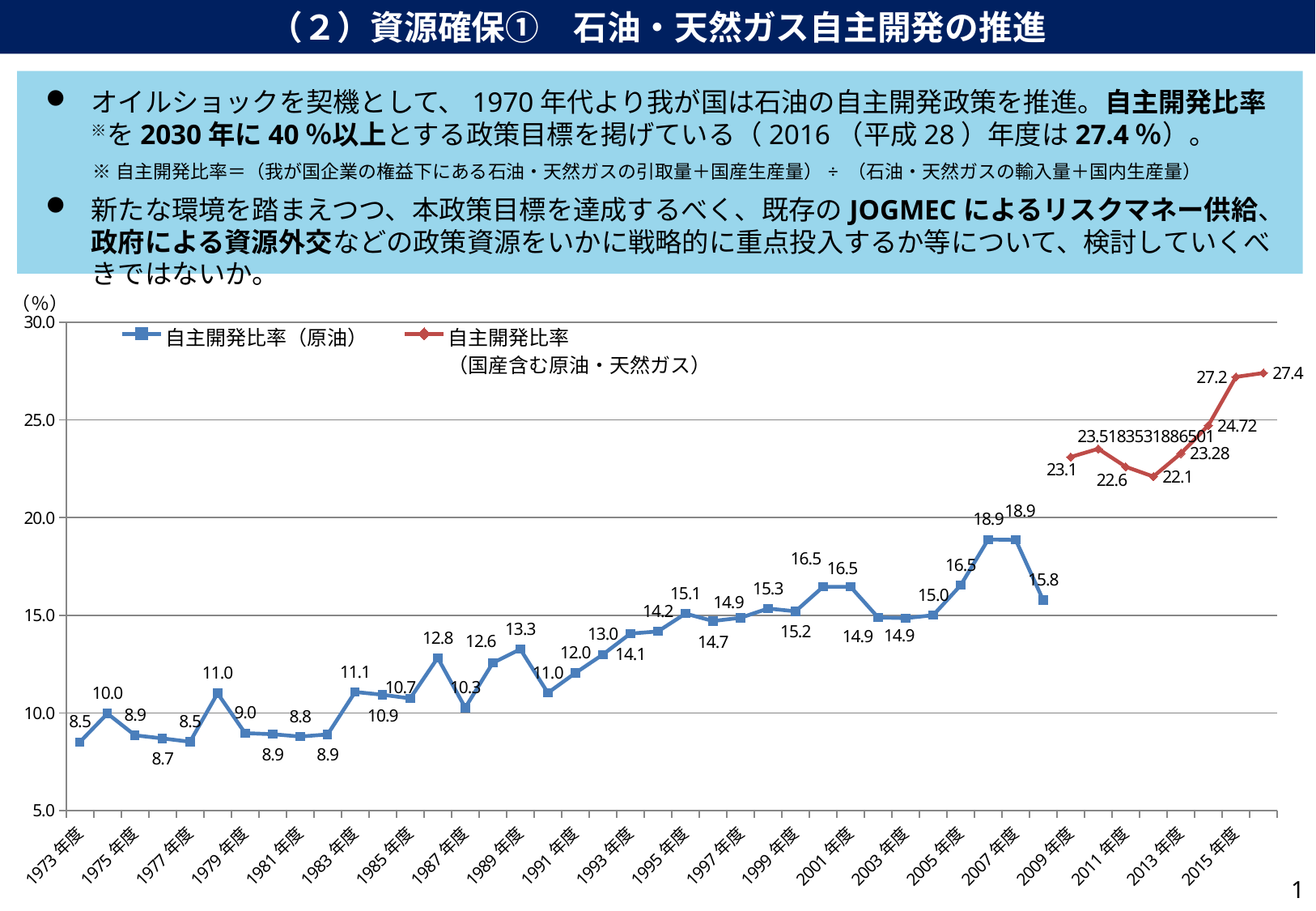
What is the lowest value plotted for 自主開発比率（国産含む原油・天然ガス）? 22.1 What is the difference between the last value of 自主開発比率（国産含む原油・天然ガス） (27.4) and its value for 2009年度 (23.1)? 4.3 What is the value of 自主開発比率（国産含む原油・天然ガス） for 2009年度? 23.1 What is the value of 自主開発比率（原油） for 1973年度? 8.5 What is the value of 自主開発比率（国産含む原油・天然ガス） for 2015年度? 27.2 What is the highest value plotted for 自主開発比率（国産含む原油・天然ガス）? 27.4 What kind of chart is shown on the slide? Line chart Which is larger: 自主開発比率（原油） for 1989年度 or for 1991年度? 1989年度 What is the value of 自主開発比率（原油） for 2007年度? 18.9 What is the value of 自主開発比率（原油） for 1995年度? 15.1 Overall, does 自主開発比率（原油） rise or fall from 1973年度 to 2007年度? Rise How many series does the legend list? 2